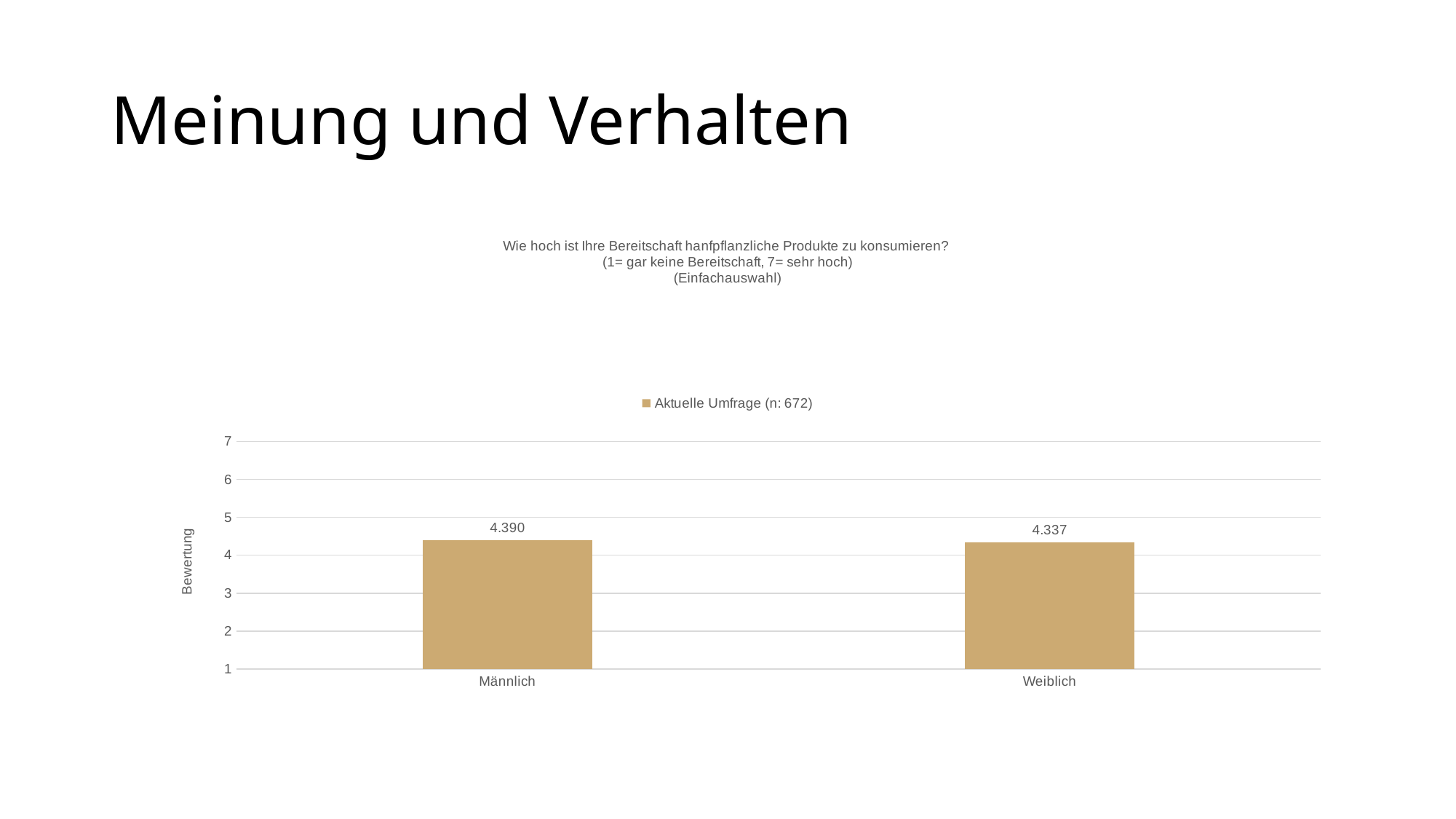
Is the value for Weiblich greater or less than 4? greater Is the value for Männlich greater or less than 5? less What is the value for Männlich? 4.390 What is the difference between the values for Männlich and Weiblich? 0.053 What is the value for Weiblich? 4.337 How many series does the legend list? 1 What is the label of the y axis? Bewertung Which category has the lowest value? Weiblich Which category has the higher value, Männlich or Weiblich? Männlich What is the series name shown in the legend? Aktuelle Umfrage (n: 672) What kind of chart is shown on the slide? bar chart How many categories are shown on the x axis? 2